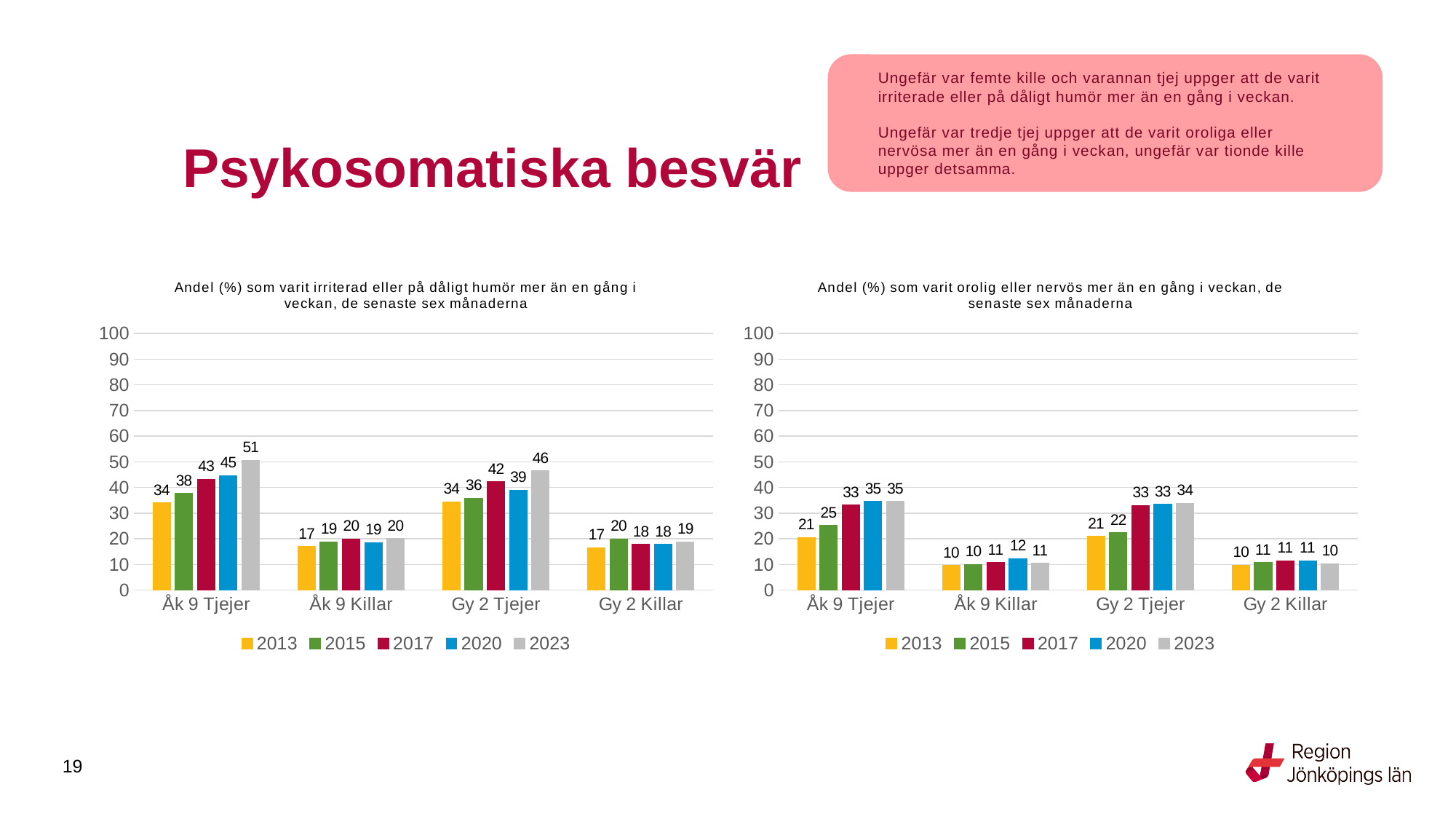
How many categories are shown on the x axis of the left chart (irriterad eller på dåligt humör)? 4 In the left chart (irriterad eller på dåligt humör), which category has the highest value for 2023? Åk 9 Tjejer In the left chart (irriterad eller på dåligt humör), what is the difference between the 2023 and 2013 values for Åk 9 Tjejer? 17 What kind of chart is the left chart (irriterad eller på dåligt humör)? Bar chart In the left chart (irriterad eller på dåligt humör), which is larger for 2020: Gy 2 Tjejer or Åk 9 Tjejer? Åk 9 Tjejer In the right chart (orolig eller nervös), which category has the lowest value for 2013? Åk 9 Killar and Gy 2 Killar (both 10) In the right chart (orolig eller nervös), is the value for Gy 2 Tjejer in 2023 greater or less than 30? greater In the right chart (orolig eller nervös), what is the difference between the 2020 values for Åk 9 Tjejer and Åk 9 Killar? 23 In the left chart (irriterad eller på dåligt humör), what is the value for Åk 9 Tjejer in 2023? 51 How many series does the legend of the right chart (orolig eller nervös) list? 5 In the right chart (orolig eller nervös), what is the value for Gy 2 Tjejer in 2017? 33 In the right chart (orolig eller nervös), do the values for Åk 9 Tjejer rise or fall from 2013 to 2023? Rise